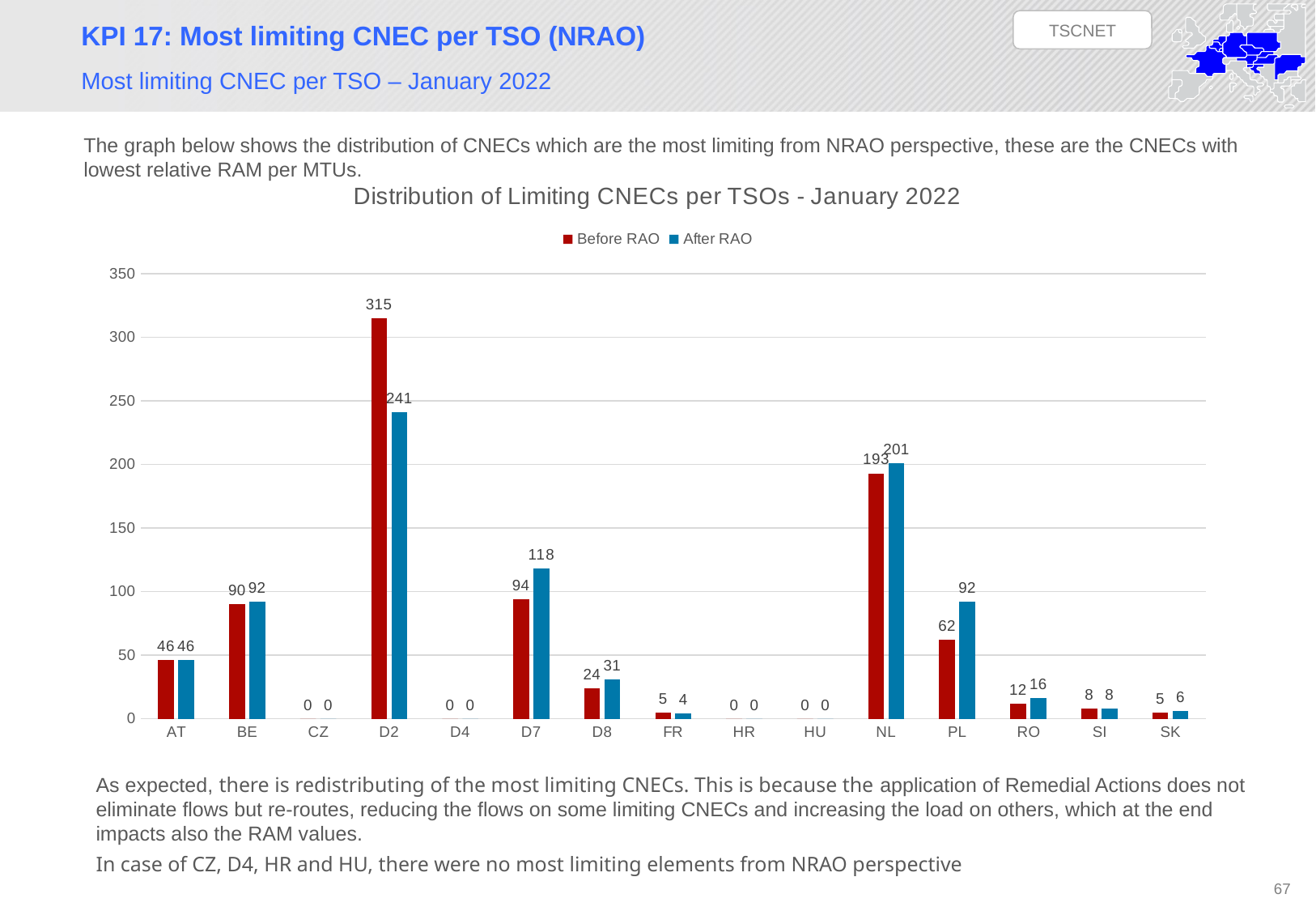
What is the After RAO value for D7? 118 How many series does the legend list? 2 How many TSO categories are shown on the x axis? 15 What is the After RAO value for PL? 92 What is the difference between the Before RAO and After RAO values for D2? 74 What is the Before RAO value for D2? 315 Which TSO has the highest Before RAO value? D2 What is the difference between the After RAO values for NL and PL? 109 Which is larger for NL, the Before RAO value or the After RAO value? After RAO What kind of chart is shown on the slide? Bar chart Which TSO has the highest After RAO value? D2 What is the title of the chart? Distribution of Limiting CNECs per TSOs - January 2022